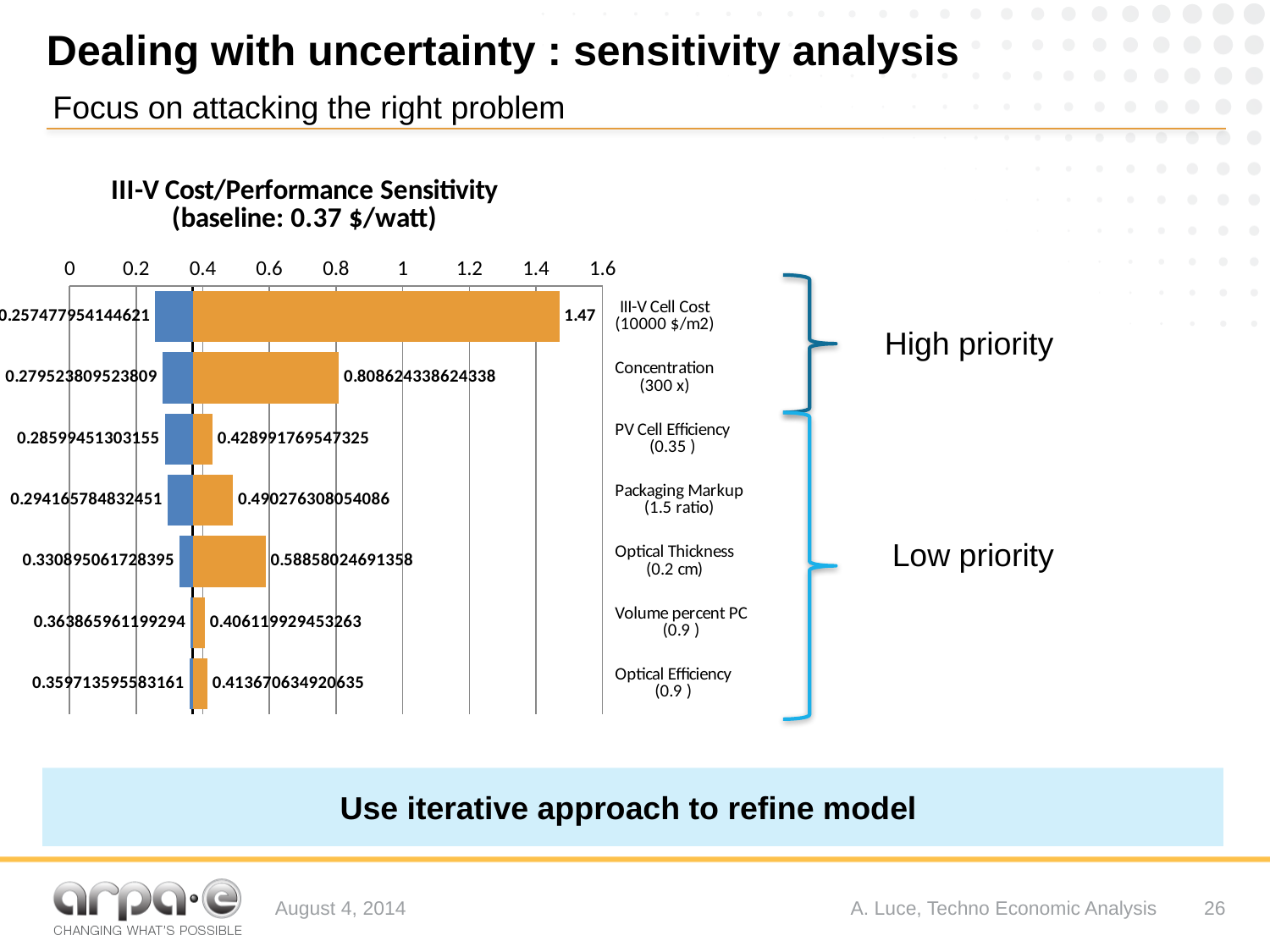
What is the title of the chart? III-V Cost/Performance Sensitivity (baseline: 0.37 $/watt) Which category has the highest high-side (orange bar) value? III-V Cell Cost (10000 $/m2) Which category has the lowest low-side (blue bar) value? III-V Cell Cost (10000 $/m2) What type of chart is shown on the slide? bar chart How many categories (parameters) are plotted in the chart? 7 Which has the larger high-side value: Concentration (300 x) or Optical Thickness (0.2 cm)? Concentration (300 x) What is the high-side (orange bar) value for Concentration (300 x)? 0.808624338624338 What is the high-side (orange bar) value for Packaging Markup (1.5 ratio)? 0.490276308054086 What is the low-side (blue bar) value for Optical Thickness (0.2 cm)? 0.330895061728395 What is the low-side (blue bar) value for Volume percent PC (0.9)? 0.363865961199294 Is the high-side value for PV Cell Efficiency (0.35) greater or less than 0.6? less What is the high-side (orange bar) value for III-V Cell Cost (10000 $/m2)? 1.47